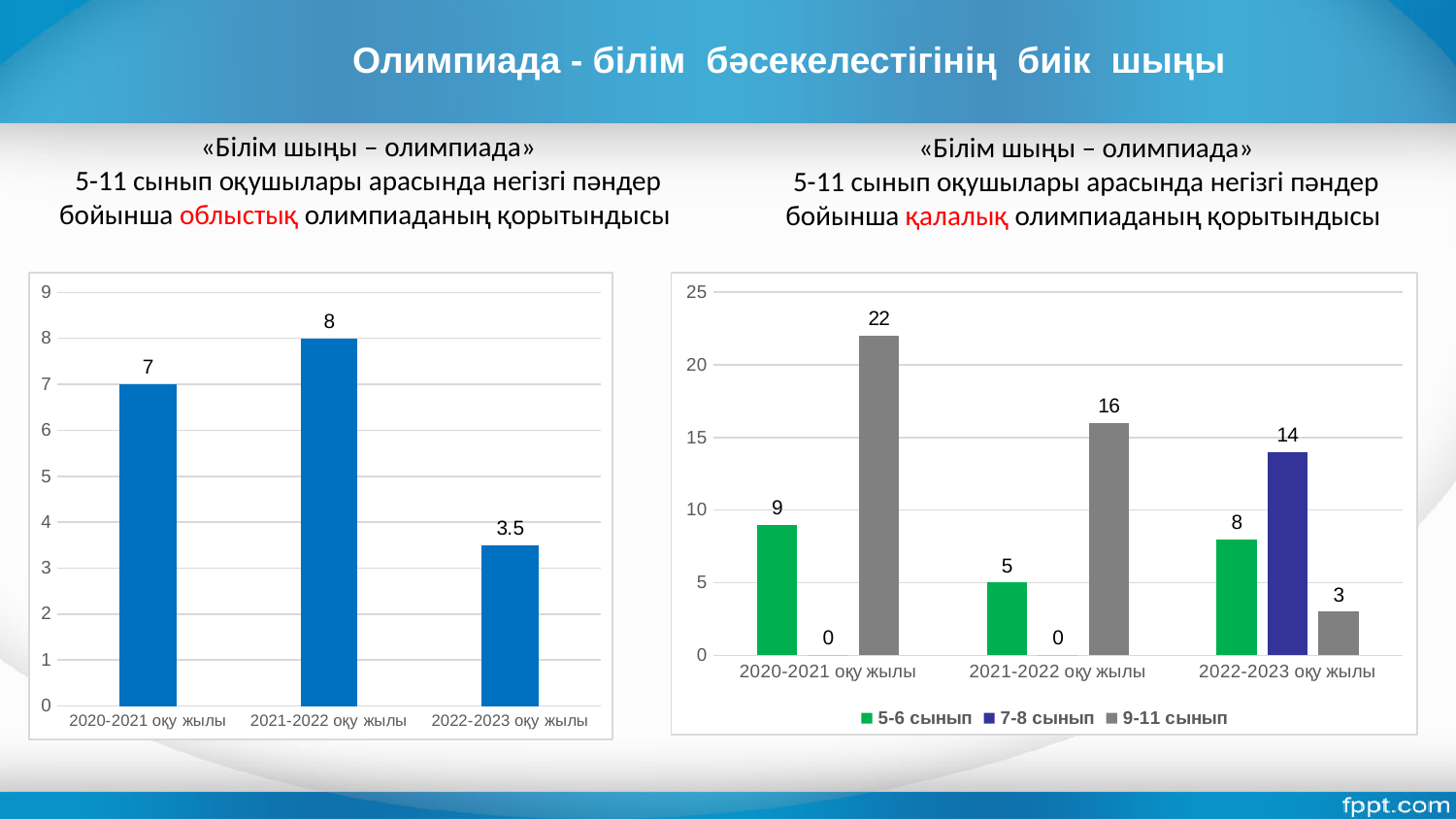
In the left chart, what is the difference between the values for 2020-2021 оқу жылы and 2022-2023 оқу жылы? 3.5 In the left chart, what is the value for 2022-2023 оқу жылы? 3.5 What type of chart is the right chart? Bar chart In the right chart, what is the value for 7-8 сынып in 2022-2023 оқу жылы? 14 In the right chart, which is larger in 2022-2023 оқу жылы: 5-6 сынып or 9-11 сынып? 5-6 сынып In the right chart, how many series does the legend list? 3 In the left chart, what is the value for 2021-2022 оқу жылы? 8 In the right chart, what is the value for 9-11 сынып in 2020-2021 оқу жылы? 22 In the right chart, what is the value for 5-6 сынып in 2021-2022 оқу жылы? 5 In the left chart, how many years are shown on the x axis? 3 In the right chart, what is the difference between the 9-11 сынып values for 2020-2021 оқу жылы and 2021-2022 оқу жылы? 6 In the left chart, which year has the highest value? 2021-2022 оқу жылы